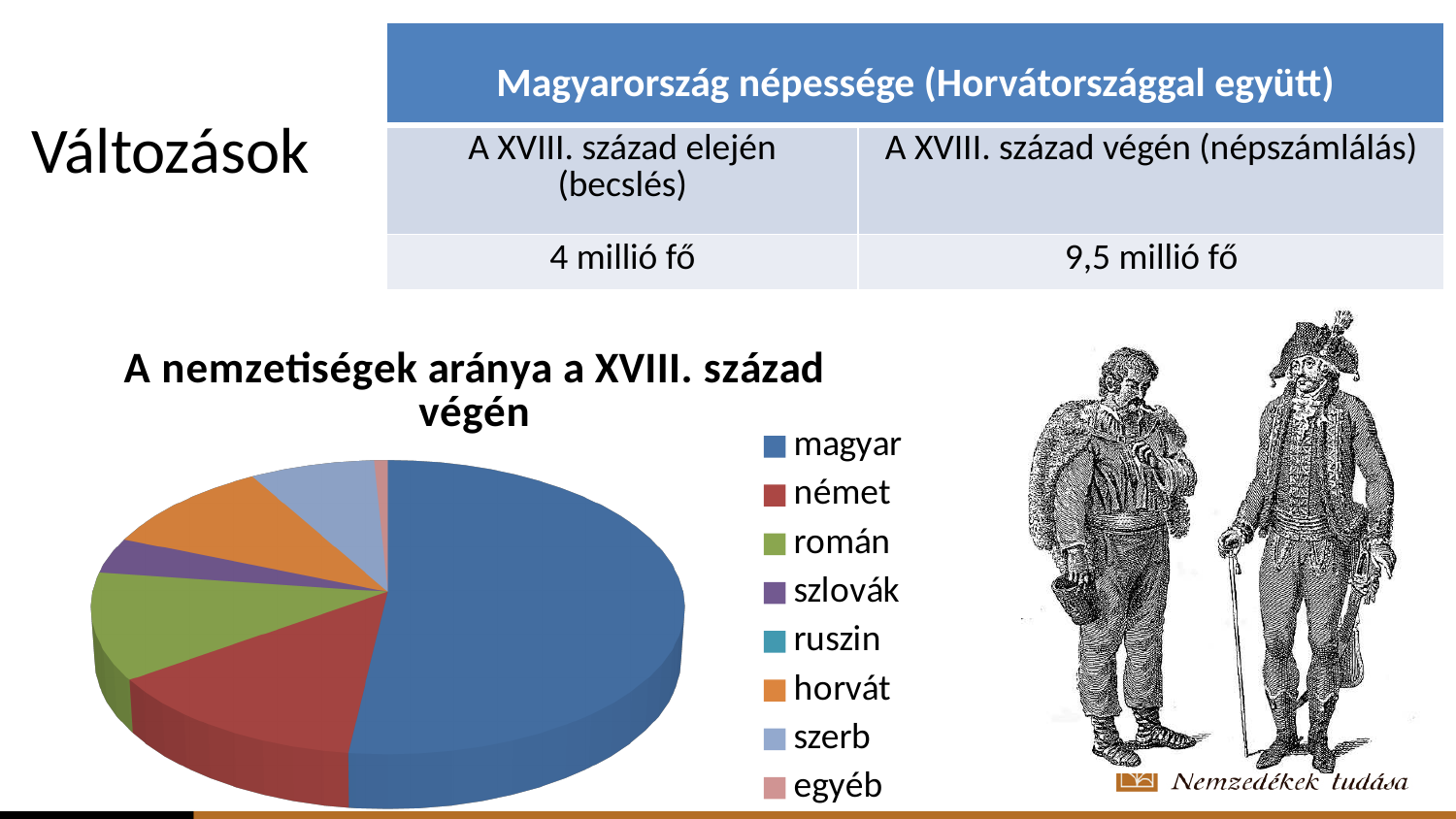
Which slice is larger in the pie chart, magyar or német? magyar Which legend entry is listed last in the pie chart's legend? egyéb Which slice is larger in the pie chart, horvát or egyéb? horvát What kind of chart is shown on the slide? pie chart Which slice is larger in the pie chart, román or szlovák? román What colour represents magyar in the pie chart? blue Which nationality has the largest slice in the pie chart? magyar What is the title of the pie chart? A nemzetiségek aránya a XVIII. század végén How many categories does the pie chart's legend list? 8